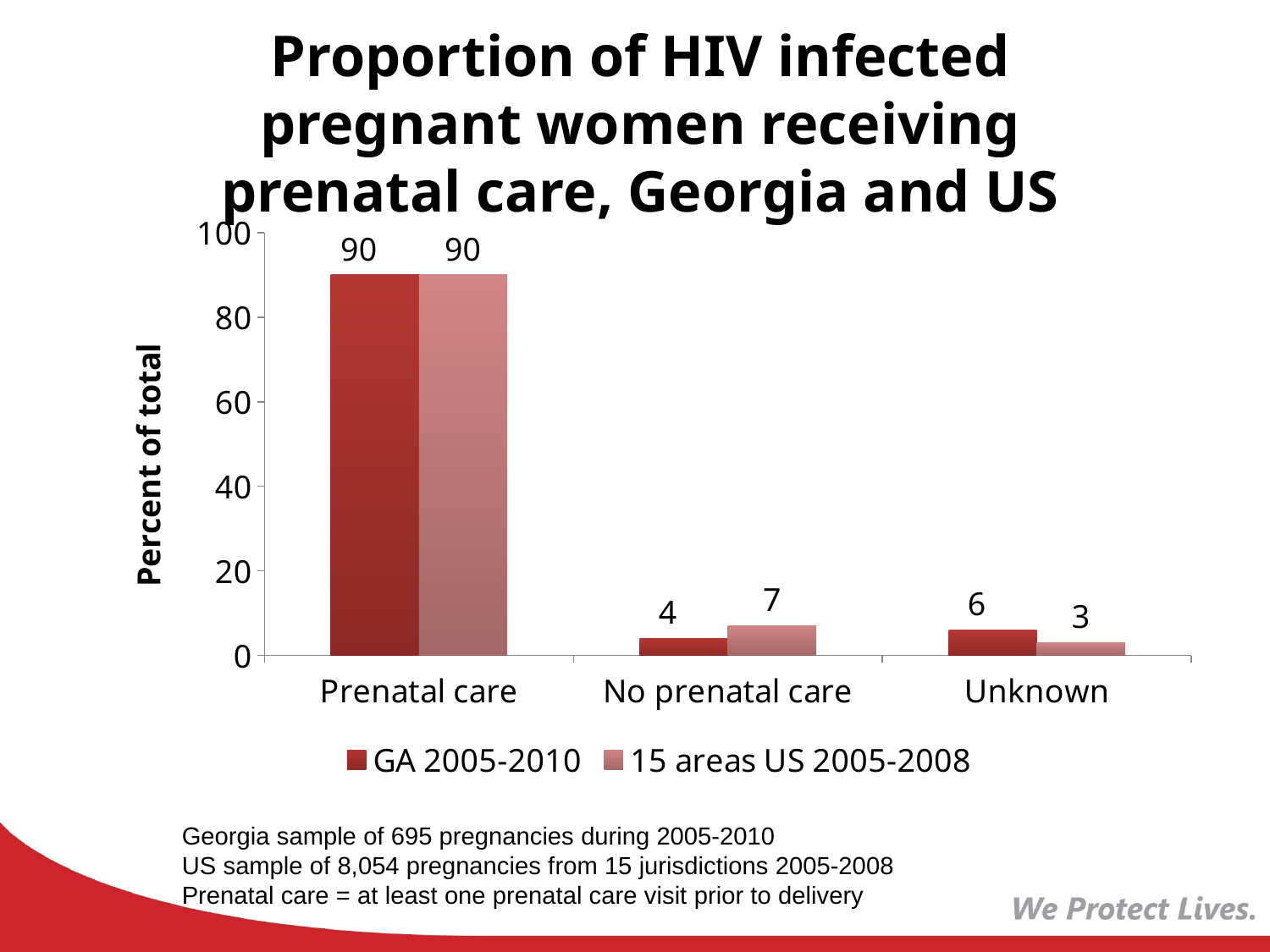
Which category has the lowest value for the GA 2005-2010 series? No prenatal care Which category has the highest value for the 15 areas US 2005-2008 series? Prenatal care What is the value for 15 areas US 2005-2008 in the Unknown category? 3 How many categories are shown on the x axis? 3 In the Unknown category, which series has the larger value, GA 2005-2010 or 15 areas US 2005-2008? GA 2005-2010 What is the value for GA 2005-2010 in the Prenatal care category? 90 What is the value for GA 2005-2010 in the Unknown category? 6 Is the value for GA 2005-2010 in the Prenatal care category greater or less than 80? greater What kind of chart is shown on the slide? Bar chart What is the value for 15 areas US 2005-2008 in the No prenatal care category? 7 How many series does the legend list? 2 What is the difference between the GA 2005-2010 and 15 areas US 2005-2008 values in the No prenatal care category? 3